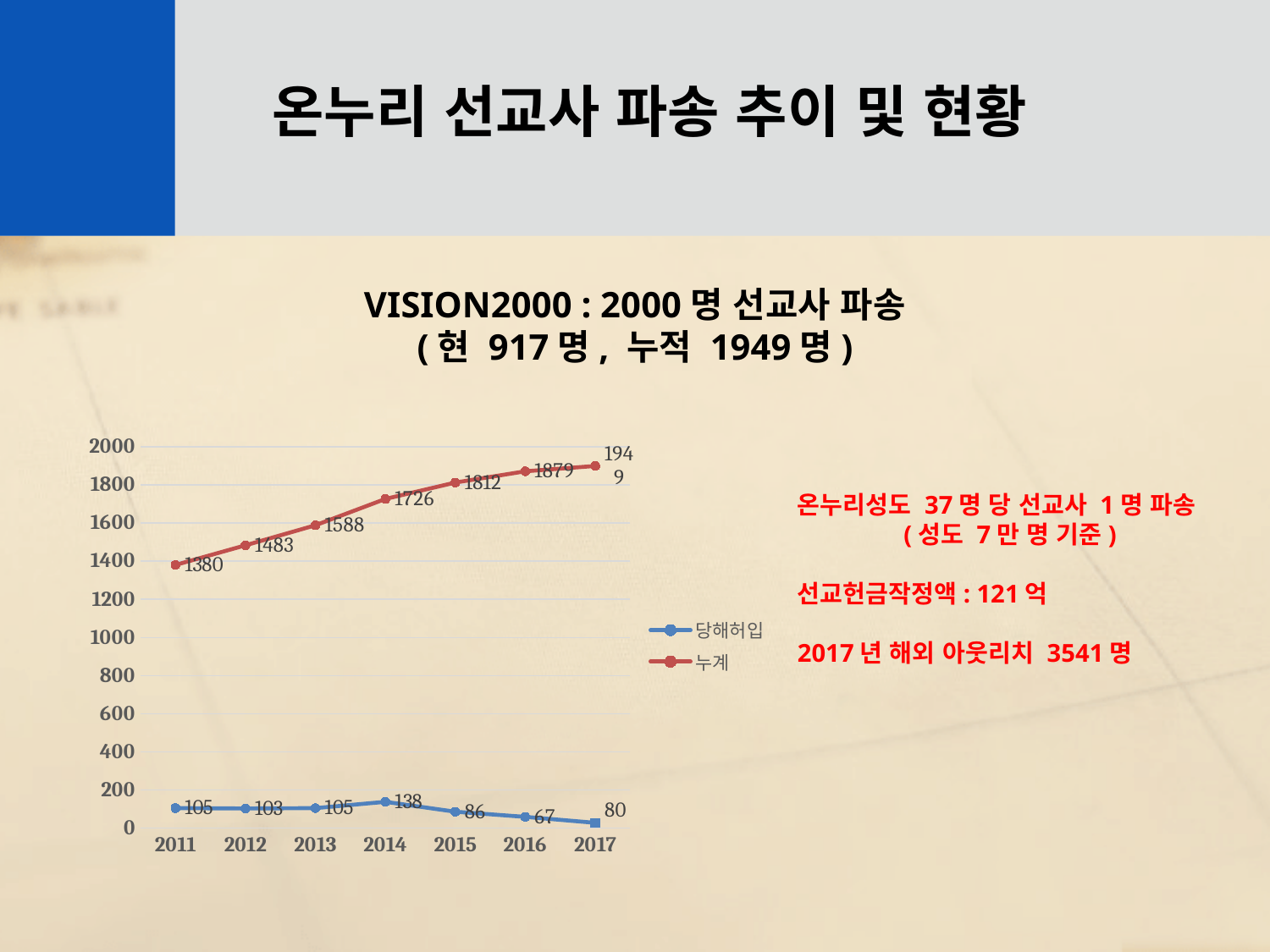
In which year is 당해허입 highest? 2014 What is the value of 누계 in 2014? 1726 Does the 누계 series rise or fall from 2011 to 2017? rise What is the value of 당해허입 in 2016? 67 What is the value of 누계 in 2011? 1380 What type of chart is shown on the slide? line chart How many series does the chart legend list? 2 Which is larger, 당해허입 in 2014 or 당해허입 in 2015? 2014 Which series is drawn in red on the chart? 누계 How many years are shown on the x axis of the chart? 7 What is the difference between 누계 in 2017 and 누계 in 2016? 70